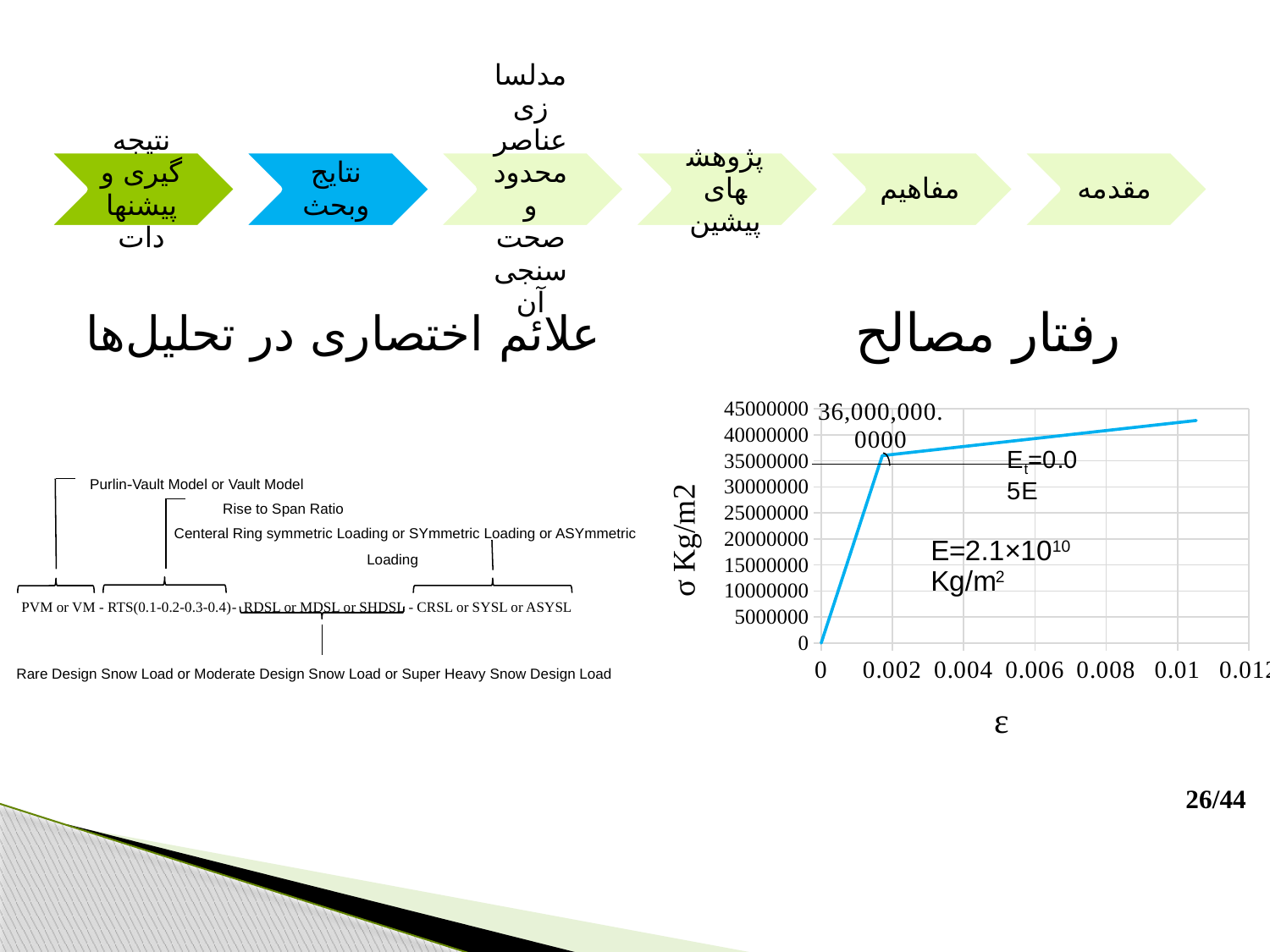
How many vertices (data points) does the plotted line have? 3 What kind of chart is shown under the title رفتار مصالح? line chart What value of E is annotated on the chart? E=2.1×10^10 Kg/m2 Is the σ value at ε = 0.001 greater or less than 30000000? less What value is printed as the data label at the kink of the stress-strain line? 36,000,000.0000 Is the σ value at ε = 0.006 greater or less than 35000000? greater Do the σ values rise or fall as ε increases along the x axis? rise What is the label of the vertical axis of the chart? σ Kg/m2 Is the σ value at ε = 0.002 greater or less than 30000000? greater